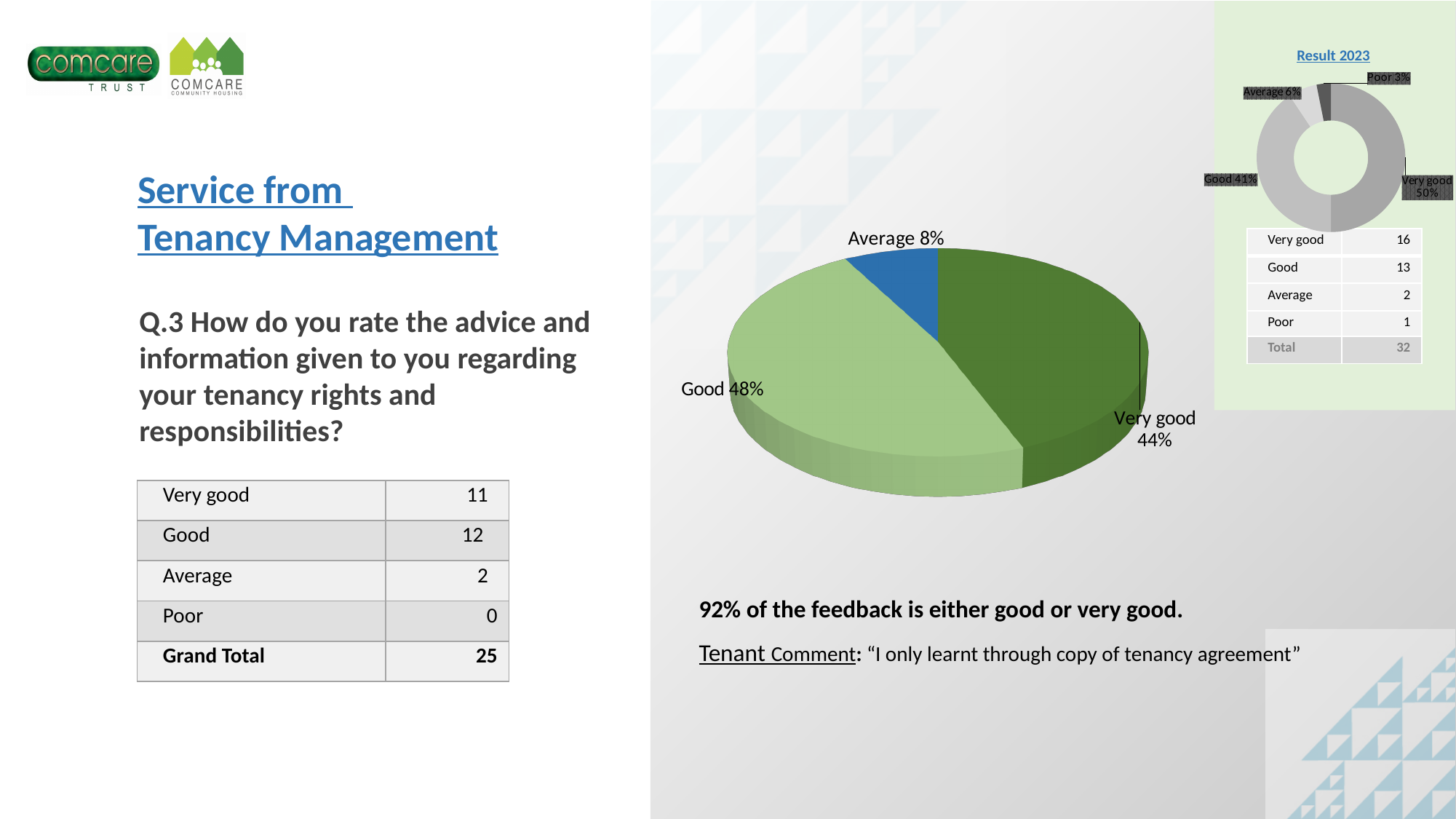
What kind of chart is the large chart in the centre of the slide? Pie chart In the large pie chart in the centre of the slide, which category has the largest slice? Good In the small donut chart titled Result 2023, which category has the largest share? Very good In the small donut chart titled Result 2023, how many categories are shown? 4 In the small donut chart titled Result 2023, what share is labelled for Poor? 3% In the large pie chart in the centre of the slide, how many slices are shown? 3 In the large pie chart in the centre of the slide, what share is labelled for Average? 8% In the large pie chart in the centre of the slide, what share is labelled for Good? 48% In the small donut chart titled Result 2023, what share is labelled for Very good? 50% In the large pie chart in the centre of the slide, which category has the smallest slice? Average In the large pie chart in the centre of the slide, what share is labelled for Very good? 44% In the large pie chart in the centre of the slide, what is the difference in percentage points between the Good and Very good slices? 4